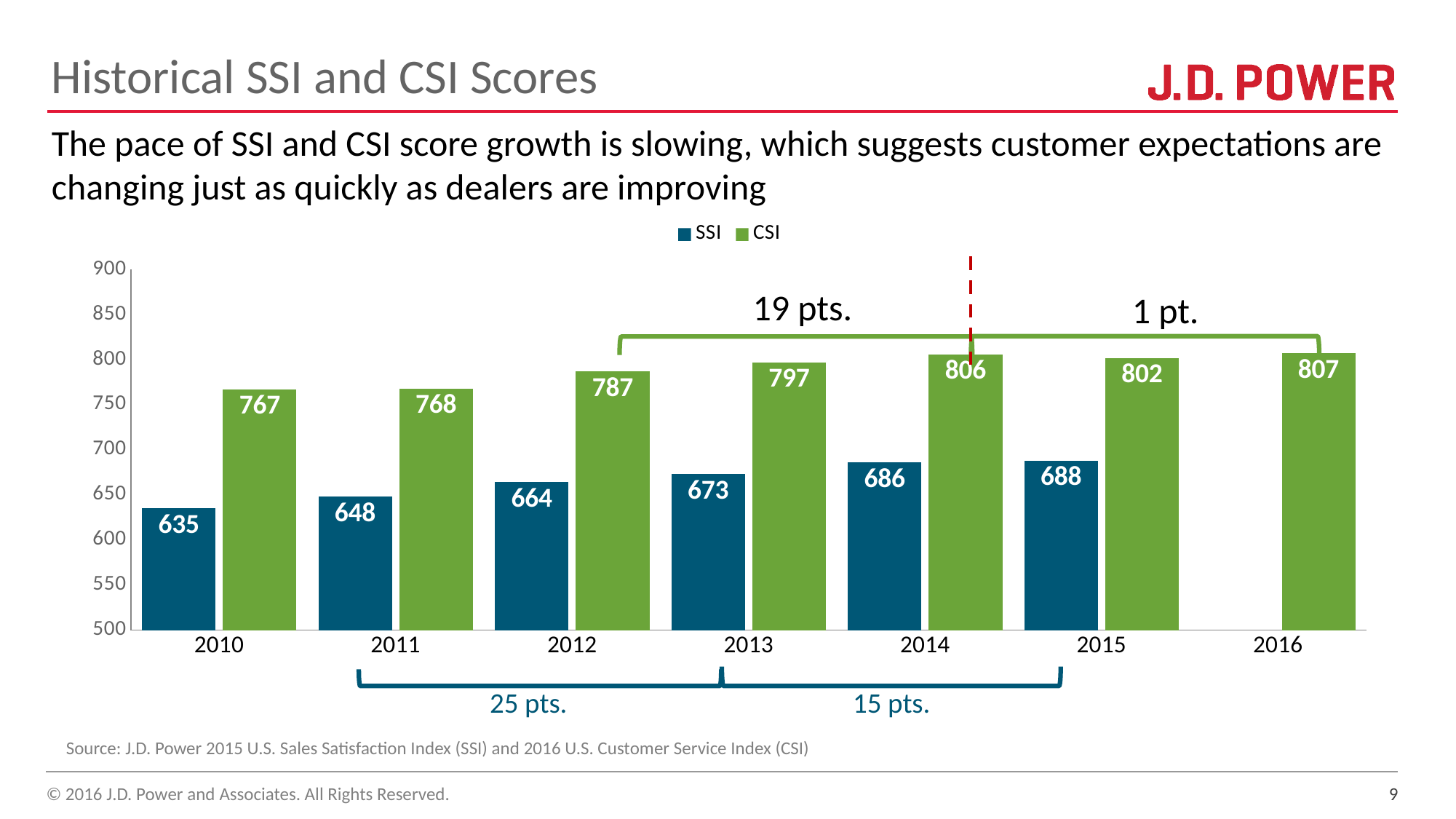
What is the difference between the SSI score in 2015 and the SSI score in 2010? 53 How many series does the legend list? 2 What is the difference between the CSI score in 2014 and the CSI score in 2012? 19 How many years are shown on the x axis? 7 Which is larger, the CSI score in 2014 or the CSI score in 2015? 2014 What is the SSI score for 2013? 673 What is the SSI score for 2010? 635 Which year has the lowest SSI score? 2010 What kind of chart is shown on the slide? Bar chart Which year has the highest CSI score? 2016 Do the CSI scores rise or fall from 2010 to 2014? Rise What is the CSI score for 2016? 807